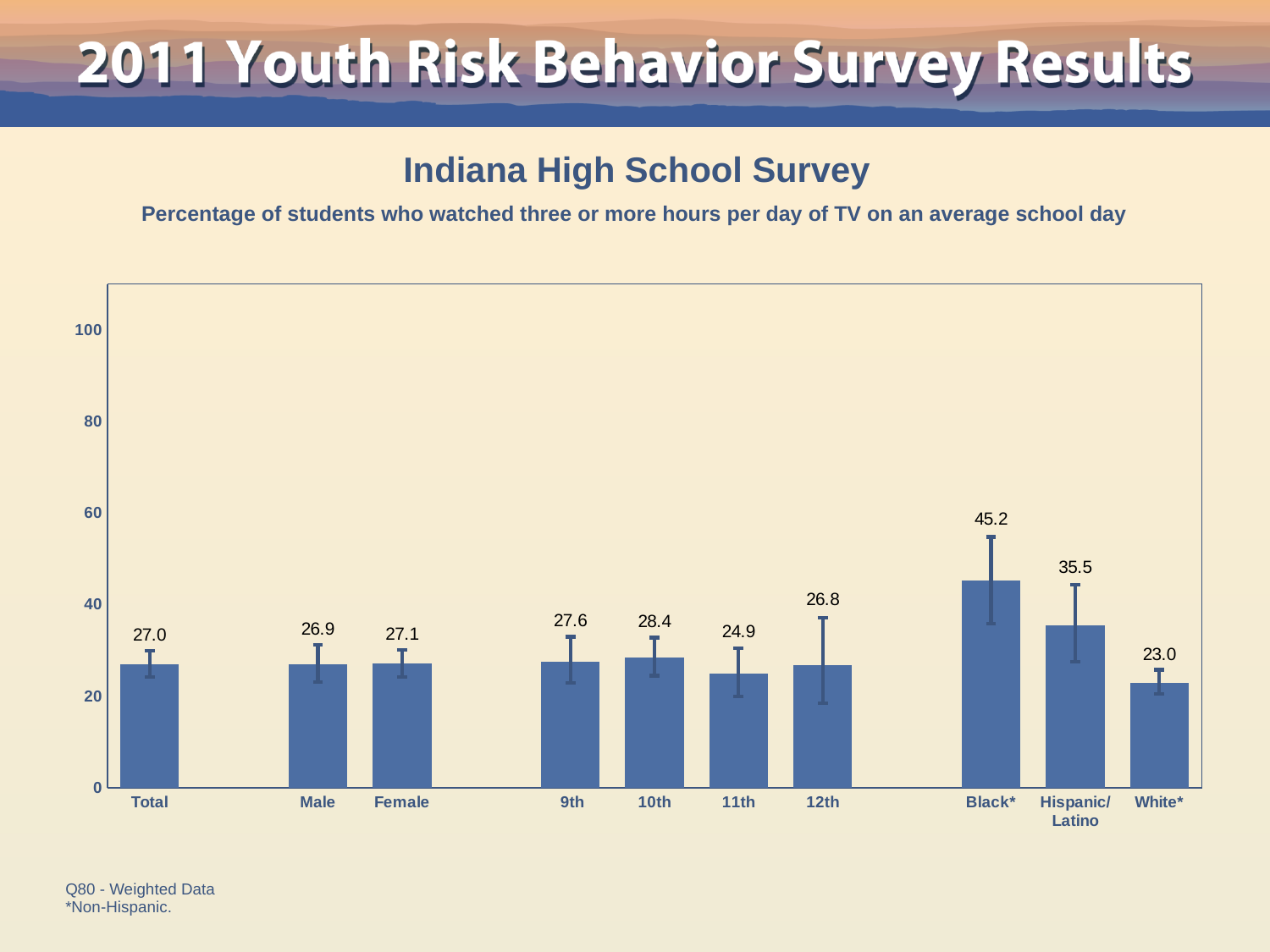
What is the value for Total? 27.0 Which category has the lowest value? White* What is the difference between the values for 10th and 11th? 3.5 Which is larger, the value for Hispanic/Latino or the value for 12th? Hispanic/Latino What is the title of the chart? Indiana High School Survey What kind of chart is shown? bar chart Which category has the highest value? Black* What is the value for 11th? 24.9 What is the difference between the values for Black* and White*? 22.2 What is the value for Black*? 45.2 How many categories are shown on the x axis? 10 Is the value for Black* greater or less than 40? greater